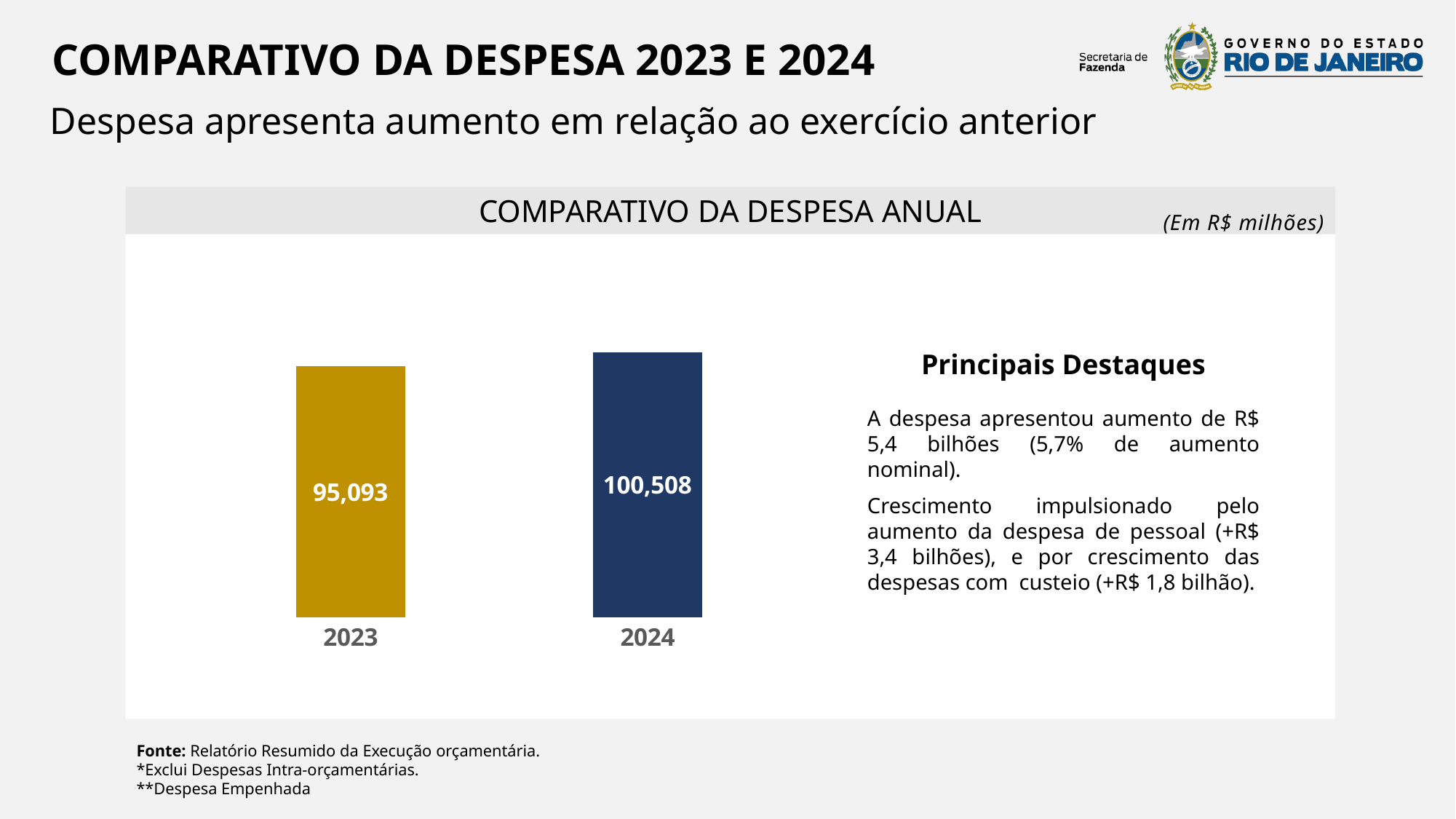
How many bars are plotted in the chart? 2 What is the value for 2023 in the chart? 95,093 What is the title of the chart? COMPARATIVO DA DESPESA ANUAL What kind of chart is shown on the slide? bar chart Which year has the higher expense value in the chart? 2024 Do the values rise or fall from 2023 to 2024? rise In what unit are the chart values expressed? R$ milhões Which year has the lower expense value in the chart? 2023 What is the value for 2024 in the chart? 100,508 Is the value for 2024 larger or smaller than the value for 2023? larger What is the difference between the 2024 and 2023 values in the chart? 5,415